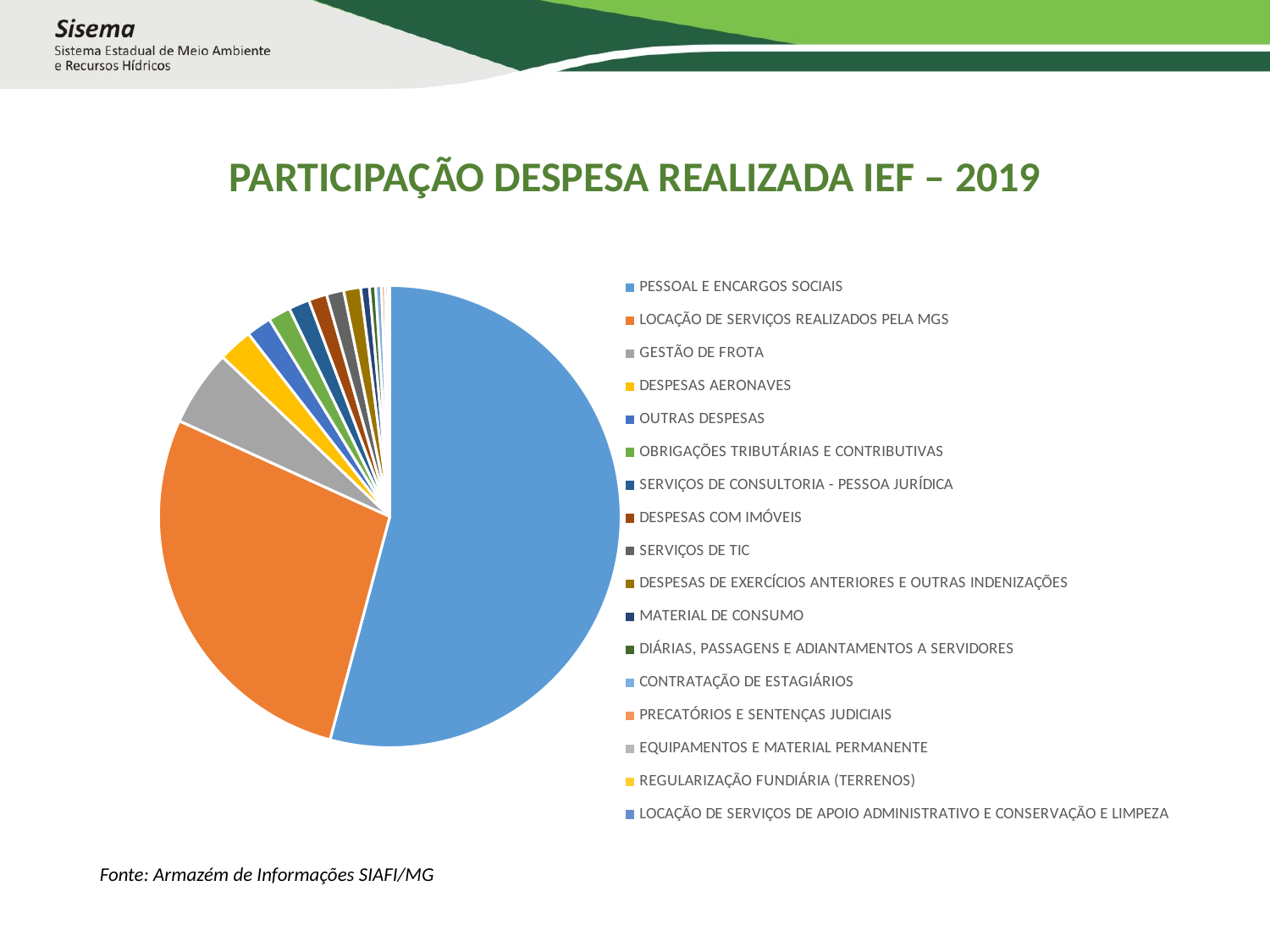
Which slice is larger: GESTÃO DE FROTA or DESPESAS AERONAVES? GESTÃO DE FROTA Which category has the largest slice of the pie? PESSOAL E ENCARGOS SOCIAIS Which category has the second largest slice of the pie? LOCAÇÃO DE SERVIÇOS REALIZADOS PELA MGS What colour is the slice for PESSOAL E ENCARGOS SOCIAIS? Blue How many categories does the legend of the pie chart list? 17 Is the slice for PESSOAL E ENCARGOS SOCIAIS larger or smaller than all the other categories combined? larger Which category is listed first in the legend? PESSOAL E ENCARGOS SOCIAIS Which slice is larger: LOCAÇÃO DE SERVIÇOS REALIZADOS PELA MGS or GESTÃO DE FROTA? LOCAÇÃO DE SERVIÇOS REALIZADOS PELA MGS What is the title of the chart? PARTICIPAÇÃO DESPESA REALIZADA IEF – 2019 What kind of chart is shown on the slide? Pie chart